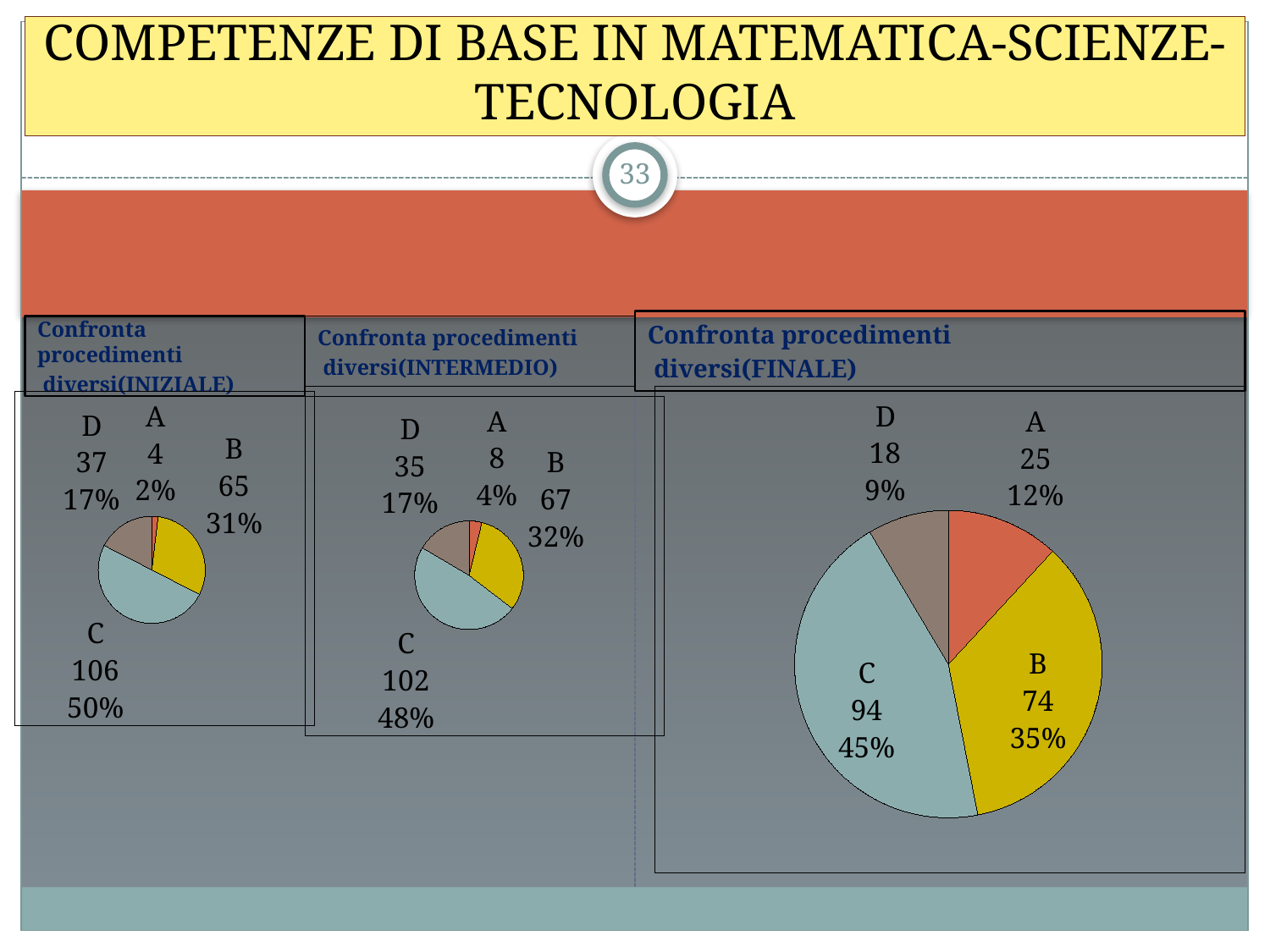
In the 'Confronta procedimenti diversi(FINALE)' chart, what is the count for category A? 25 What type of chart is used for 'Confronta procedimenti diversi(INIZIALE)'? Pie chart In the 'Confronta procedimenti diversi(INIZIALE)' chart, what is the count for category C? 106 In the 'Confronta procedimenti diversi(FINALE)' chart, what percentage share does category C have? 45% In the 'Confronta procedimenti diversi(INTERMEDIO)' chart, what is the difference between the counts for C and B? 35 In the 'Confronta procedimenti diversi(INIZIALE)' chart, what percentage share does category B have? 31% How many categories does the 'Confronta procedimenti diversi(FINALE)' chart show? 4 In the 'Confronta procedimenti diversi(INTERMEDIO)' chart, what is the count for category D? 35 In the 'Confronta procedimenti diversi(FINALE)' chart, which is larger, the value for B or the value for D? B In the 'Confronta procedimenti diversi(INIZIALE)' chart, which category has the smallest value? A In the 'Confronta procedimenti diversi(INTERMEDIO)' chart, which category has the largest value? C In the 'Confronta procedimenti diversi(FINALE)' chart, what is the difference between the counts for B and A? 49